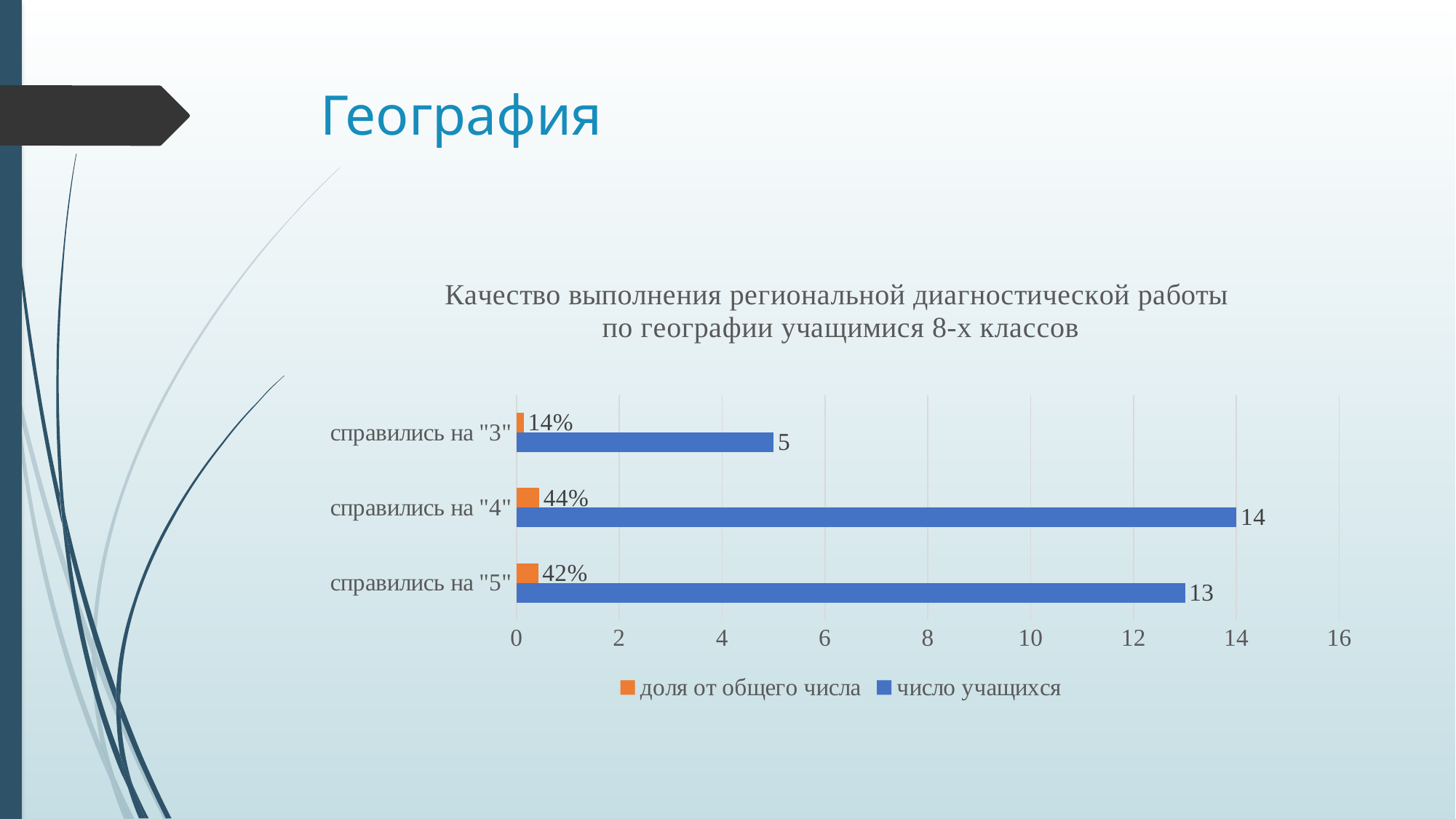
Which category has the highest number of students (число учащихся)? справились на "4" What is the number of students (число учащихся) who scored "3" (справились на "3")? 5 Which is larger: the number of students who scored "5" or the number who scored "3"? справились на "5" What is the number of students (число учащихся) who scored "4" (справились на "4")? 14 How many series does the legend list? 2 What type of chart is shown on the slide? bar chart What share of the total (доля от общего числа) scored "5" (справились на "5")? 42% How many categories are shown on the chart? 3 What is the difference in the number of students between those who scored "4" and those who scored "3"? 9 Which category has the lowest share of the total (доля от общего числа)? справились на "3" What share of the total (доля от общего числа) scored "3" (справились на "3")? 14% What colour represents the series "число учащихся" in the chart? blue